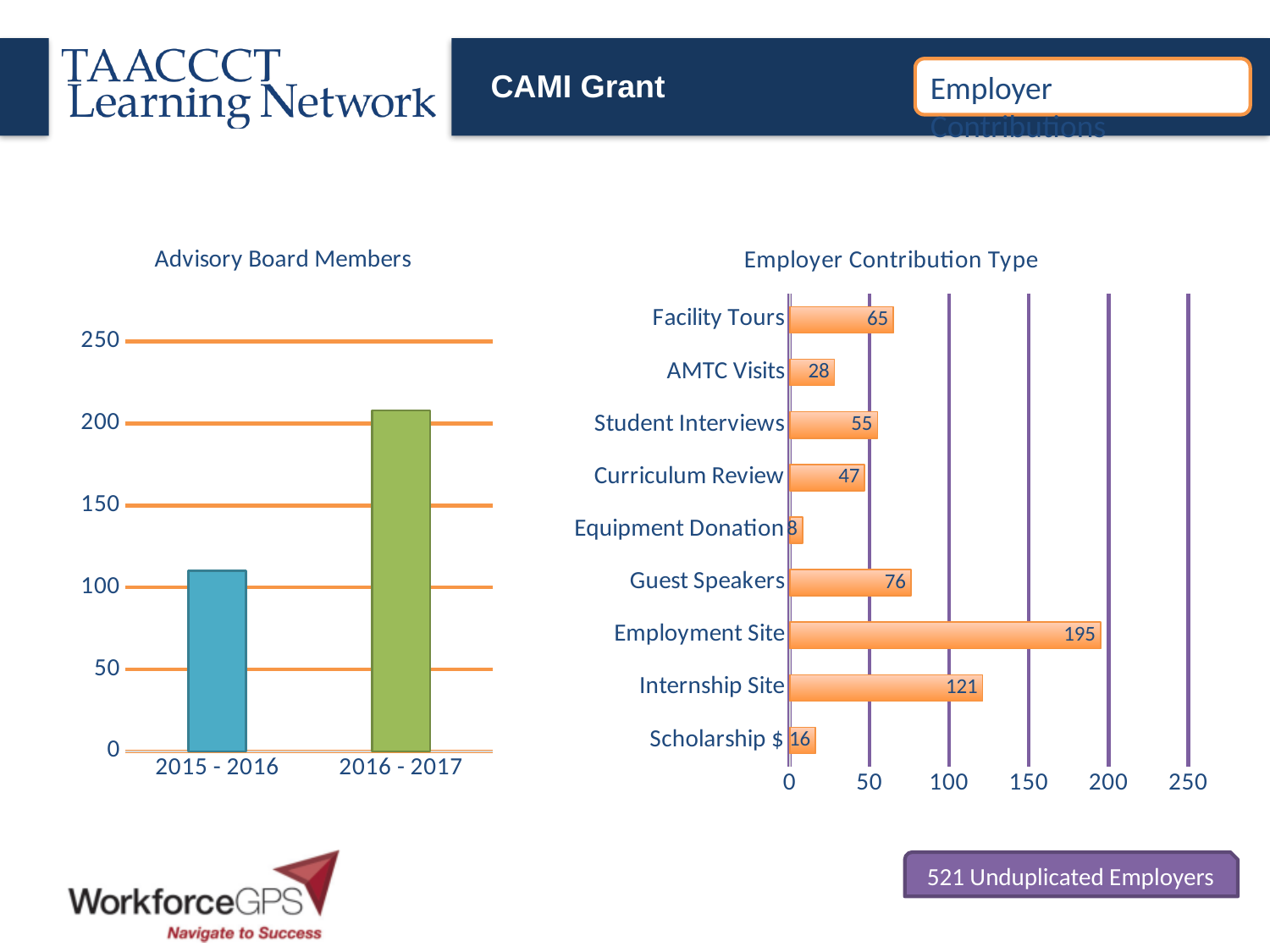
In the Advisory Board Members chart, is the value for 2015 - 2016 greater or less than 150? less In the Advisory Board Members chart, is the value for 2016 - 2017 greater or less than 200? greater In the Employer Contribution Type chart, which is larger, Guest Speakers or Facility Tours? Guest Speakers In the Advisory Board Members chart, which year has the higher value? 2016 - 2017 In the Employer Contribution Type chart, what is the difference between Employment Site and Internship Site? 74 In the Employer Contribution Type chart, what is the value for Internship Site? 121 In the Employer Contribution Type chart, what is the value for Employment Site? 195 In the Employer Contribution Type chart, which contribution type has the lowest value? Equipment Donation What type of chart is the Employer Contribution Type chart? Bar chart In the Employer Contribution Type chart, which contribution type has the highest value? Employment Site In the Employer Contribution Type chart, what is the value for Curriculum Review? 47 How many contribution types are shown in the Employer Contribution Type chart? 9